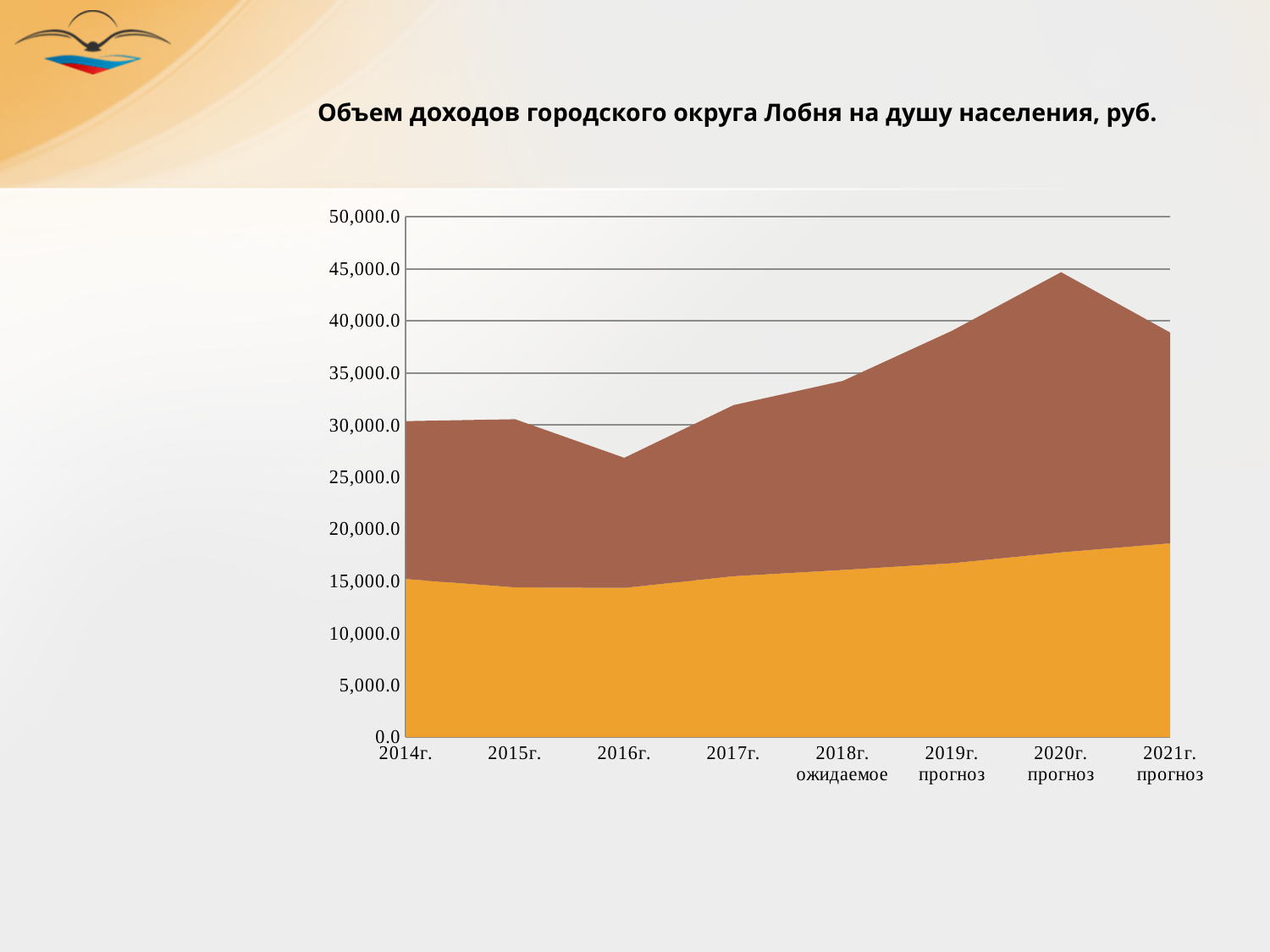
Does the orange (bottom) series rise or fall from 2016г. to 2021г. прогноз? rises What kind of chart is shown on the slide? Stacked area chart Is the total value for 2020г. прогноз greater or less than 40,000.0? greater Is the total value for 2016г. greater or less than 30,000.0? less In which year is the total (top of the stacked area) at its lowest? 2016г. Which year has the larger total value: 2020г. прогноз or 2021г. прогноз? 2020г. прогноз How many years (points) are shown along the x axis of the chart? 8 How many data series (coloured areas) are stacked in the chart? 2 Is the total value for 2019г. прогноз greater or less than 35,000.0? greater In which year does the total (top of the stacked area) reach its highest value? 2020г. прогноз What is the title of the chart? Объем доходов городского округа Лобня на душу населения, руб.